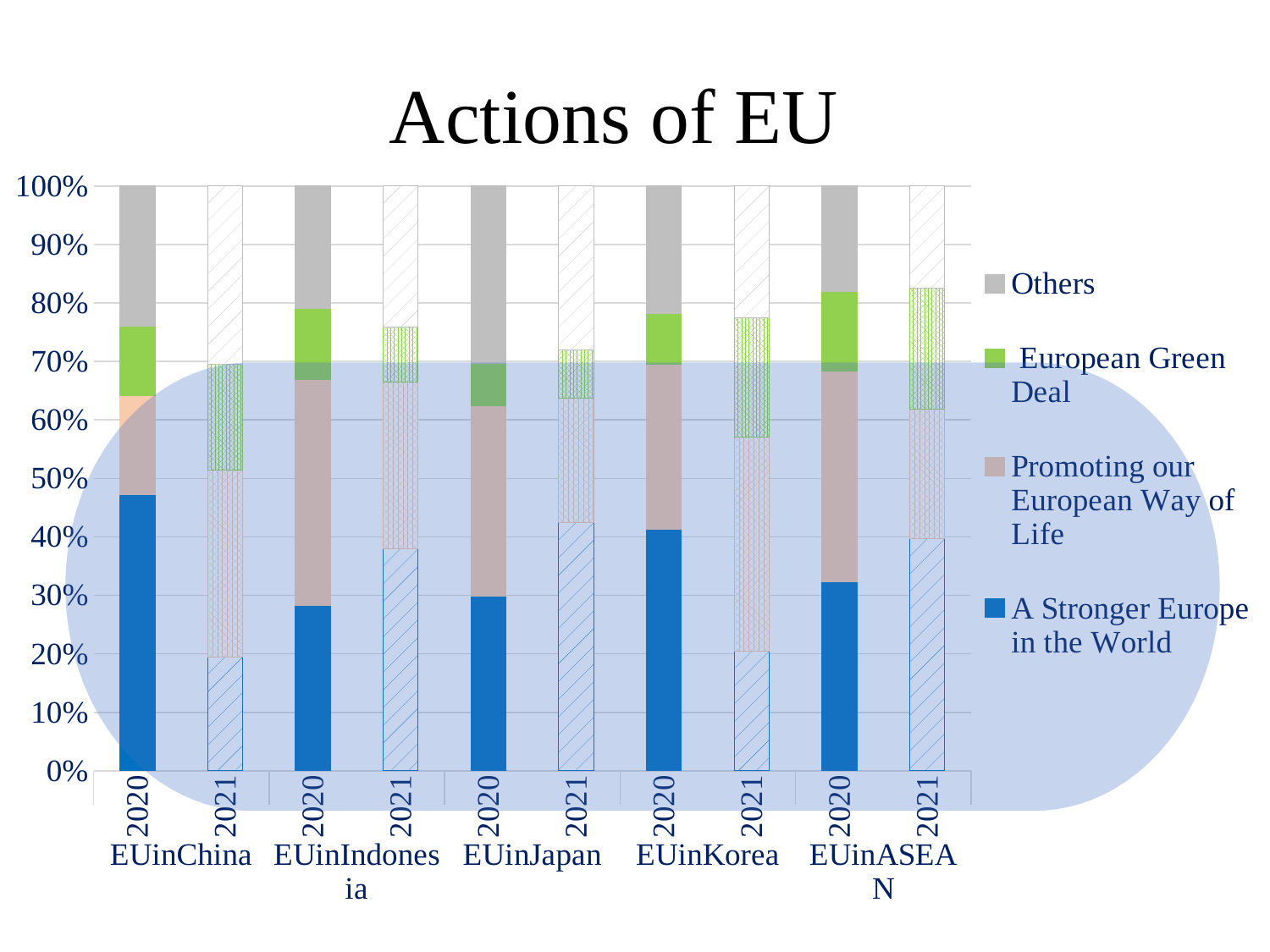
What type of chart is shown on the slide? Stacked bar chart Does the 'A Stronger Europe in the World' share for EUinIndonesia rise or fall from 2020 to 2021? rise Which has the larger 'A Stronger Europe in the World' share in 2020: EUinChina or EUinIndonesia? EUinChina What is the title of the chart? Actions of EU Is the 'A Stronger Europe in the World' share for EUinIndonesia in 2020 greater or less than 30%? less Which bar has the highest 'A Stronger Europe in the World' share? EUinChina 2020 How many EU delegation categories are shown on the x axis? 5 Is the 'A Stronger Europe in the World' share for EUinChina in 2021 greater or less than 30%? less Is the 'A Stronger Europe in the World' share for EUinChina in 2020 greater or less than 40%? greater How many bars are plotted in total on the chart? 10 How many series does the legend list? 4